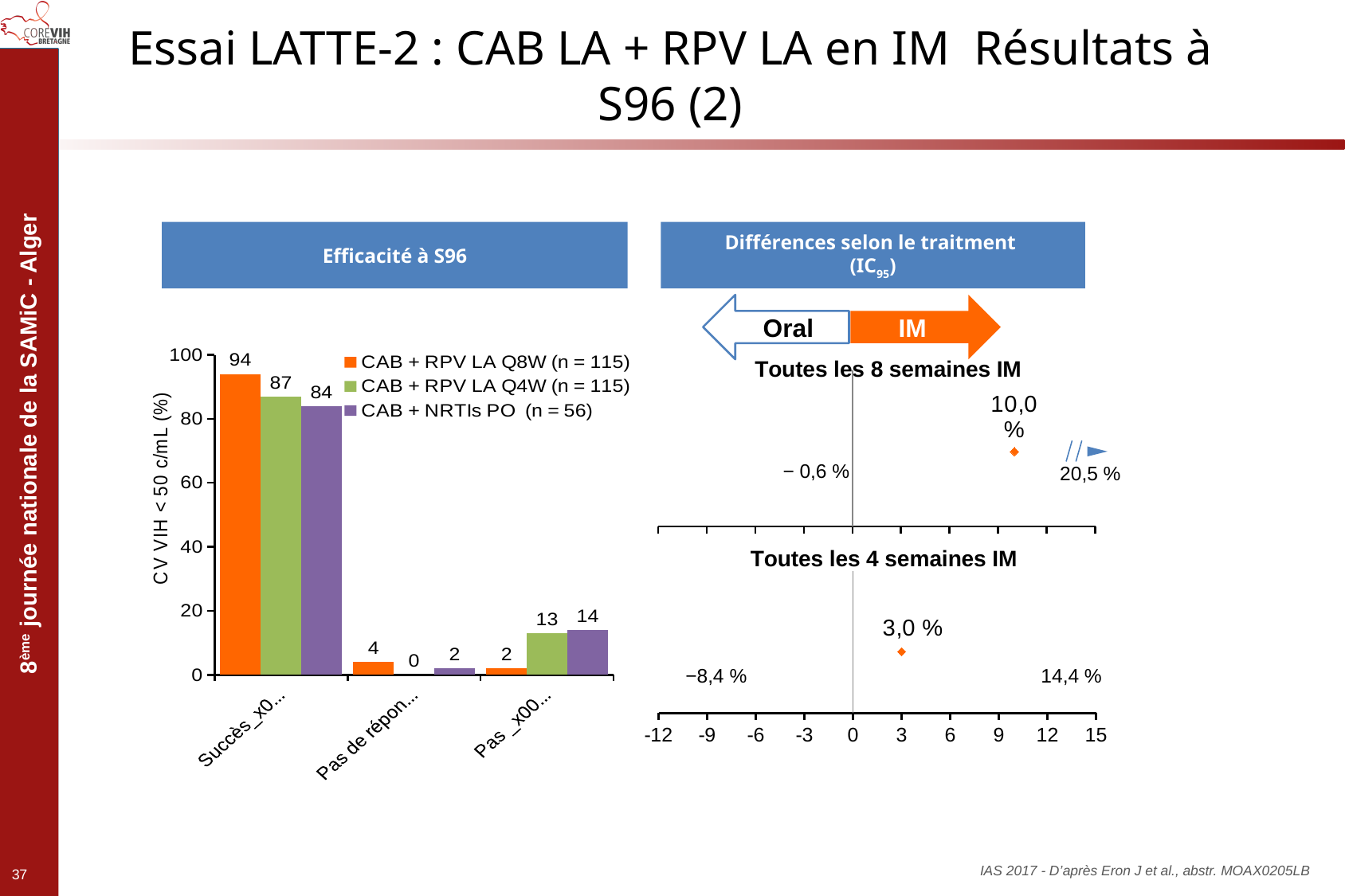
How many series does the legend of the 'Efficacité à S96' chart list? 3 In the 'Efficacité à S96' chart, what value is shown for CAB + NRTIs PO (n = 56) in the first category (Succès)? 84 In the 'Efficacité à S96' chart, what value is shown for CAB + RPV LA Q4W (n = 115) in the 'Pas de répon...' category? 0 In the 'Efficacité à S96' chart, what is the difference between the CAB + RPV LA Q8W and CAB + NRTIs PO values in the first category (Succès)? 10 In the 'Efficacité à S96' chart, which series has the highest value in the first category (Succès)? CAB + RPV LA Q8W (n = 115) What kind of chart is the 'Efficacité à S96' chart? Bar chart In the 'Différences selon le traitment' chart, what is the point estimate shown for 'Toutes les 8 semaines IM'? 10,0 % In the 'Différences selon le traitment' chart, what is the upper confidence limit shown for 'Toutes les 4 semaines IM'? 14,4 % In the 'Différences selon le traitment' chart, what is the point estimate shown for 'Toutes les 4 semaines IM'? 3,0 % In the 'Efficacité à S96' chart, in the rightmost category, which is larger: the CAB + RPV LA Q4W value or the CAB + NRTIs PO value? CAB + NRTIs PO (n = 56) In the 'Efficacité à S96' chart, what value is shown for CAB + RPV LA Q8W (n = 115) in the first category (Succès)? 94 In the 'Efficacité à S96' chart, what value is shown for CAB + RPV LA Q4W (n = 115) in the first category (Succès)? 87